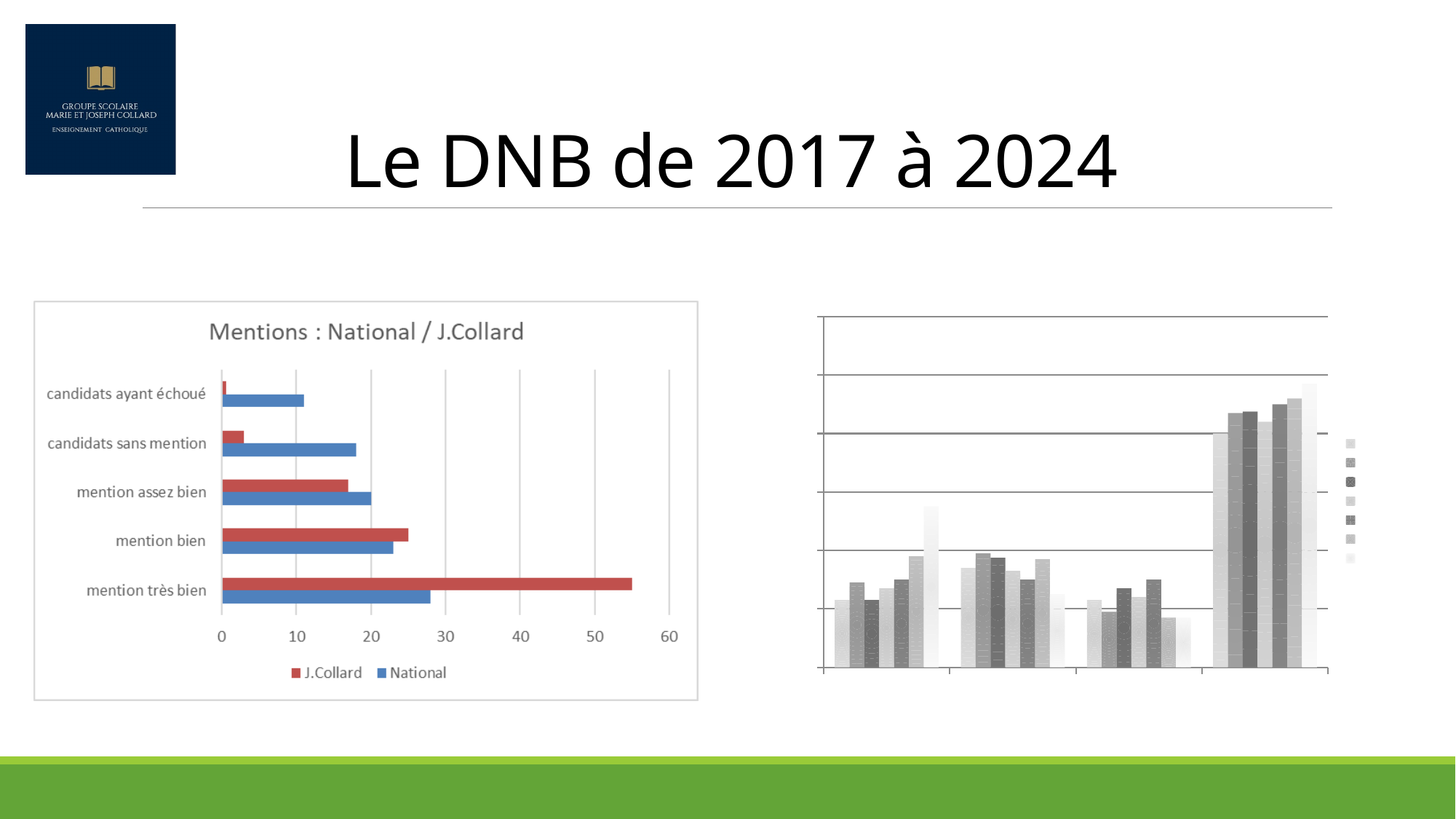
In the 'Mentions : National / J.Collard' chart, which category has the highest value for National? mention très bien How many categories are shown on the 'Mentions : National / J.Collard' chart? 5 In the 'Mentions : National / J.Collard' chart, which category has the highest value for J.Collard? mention très bien How many series does the legend of the 'Mentions : National / J.Collard' chart list? 2 In the 'Mentions : National / J.Collard' chart, is the National value for 'candidats ayant échoué' greater or less than 20? less What type of chart is the chart on the right side of the slide? bar chart In the 'Mentions : National / J.Collard' chart, for 'mention très bien', which series has the larger value, J.Collard or National? J.Collard In the 'Mentions : National / J.Collard' chart, which series is shown in red? J.Collard What type of chart is the 'Mentions : National / J.Collard' chart? bar chart In the 'Mentions : National / J.Collard' chart, which category has the lowest value for J.Collard? candidats ayant échoué In the 'Mentions : National / J.Collard' chart, for 'candidats sans mention', which series has the larger value, J.Collard or National? National In the 'Mentions : National / J.Collard' chart, is the J.Collard value for 'mention très bien' greater or less than 50? greater